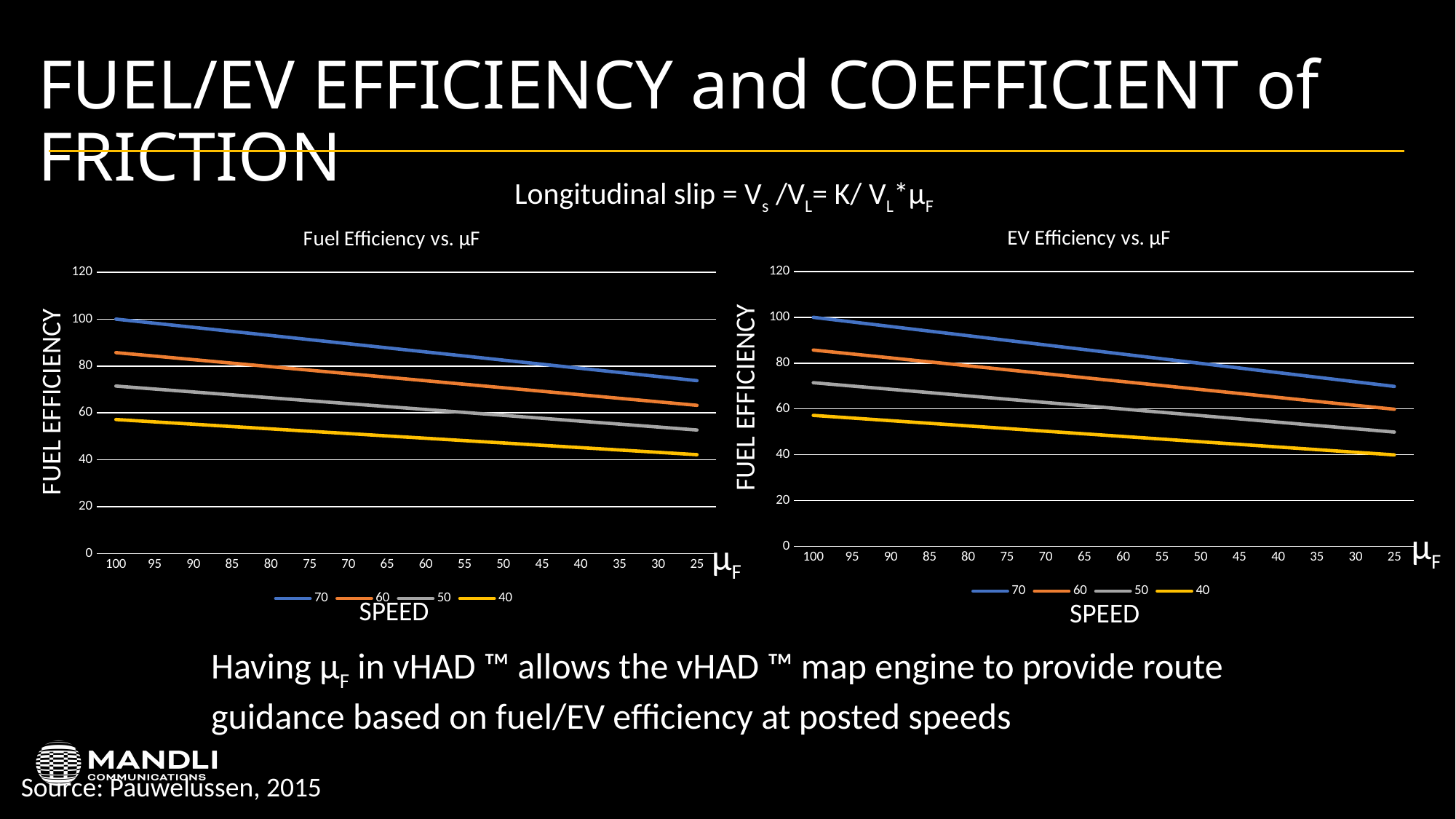
In the Fuel Efficiency vs. μF chart, do the efficiency values rise or fall moving from left to right along the x axis? fall In the Fuel Efficiency vs. μF chart, what is the fuel efficiency for the speed 70 series at μF = 100? 100 In the Fuel Efficiency vs. μF chart, is the value for the speed 60 series at μF = 100 greater or less than 80? greater In the Fuel Efficiency vs. μF chart, what kind of chart is shown? line chart In the EV Efficiency vs. μF chart, how many series does the legend list? 4 In the EV Efficiency vs. μF chart, is the value for the speed 40 series at μF = 100 greater or less than 80? less In the Fuel Efficiency vs. μF chart, which speed series has the lowest efficiency across the chart? 40 What is the label on the y axis of the EV Efficiency vs. μF chart? FUEL EFFICIENCY In the Fuel Efficiency vs. μF chart, at μF = 50, which series has the larger value: speed 60 or speed 40? 60 In the Fuel Efficiency vs. μF chart, how many μF values are marked along the x axis? 16 In the EV Efficiency vs. μF chart, which speed series has the highest efficiency across the chart? 70 In the EV Efficiency vs. μF chart, is the value for the speed 70 series at μF = 25 greater or less than 60? greater